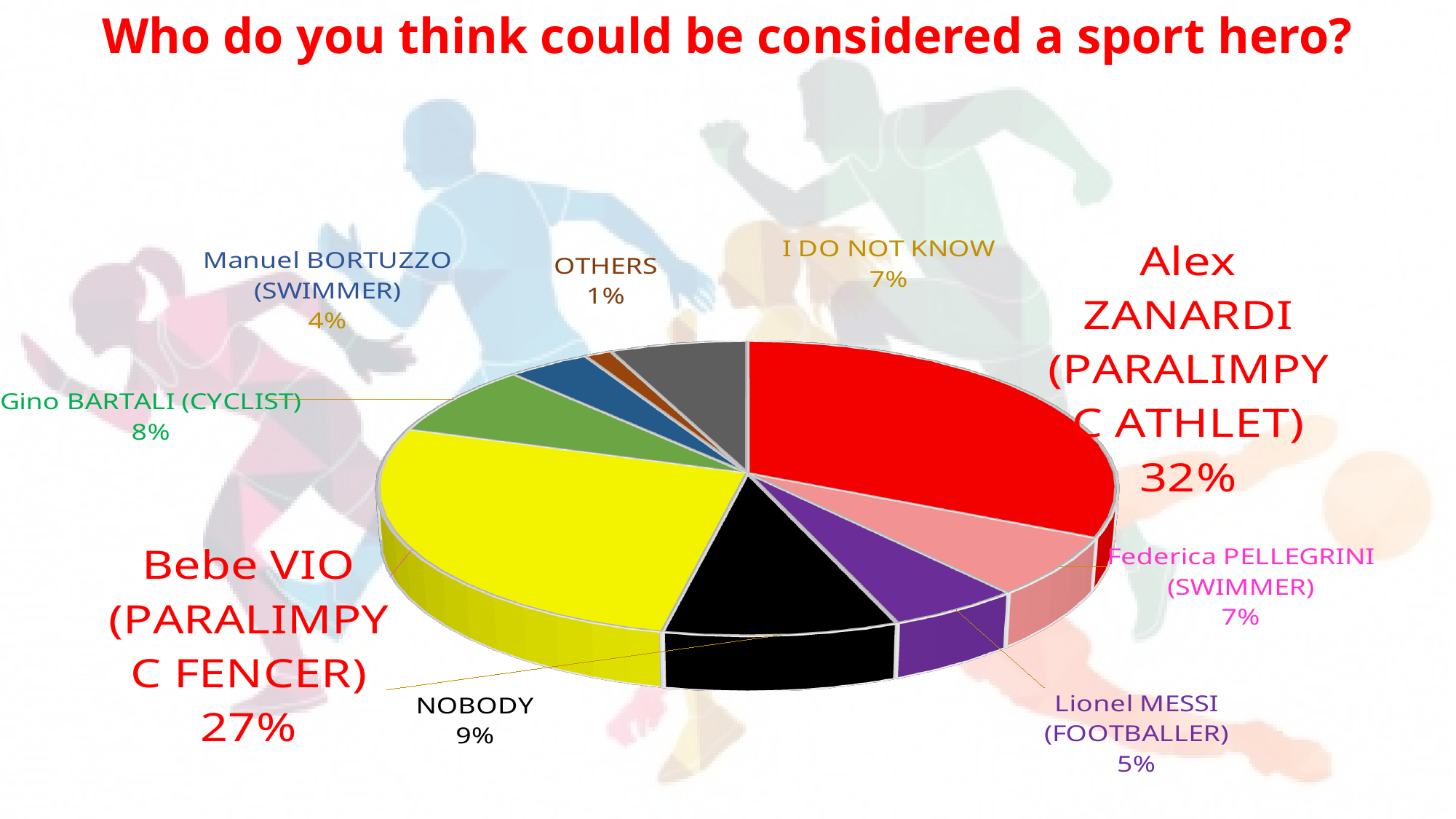
What percentage is shown for Gino BARTALI (CYCLIST)? 8% Which category has the smallest slice of the pie? OTHERS What share of the pie is Alex ZANARDI (PARALIMPYC ATHLET)? 32% What share of the pie is Bebe VIO (PARALIMPYC FENCER)? 27% What percentage of respondents answered NOBODY? 9% How many categories are shown in the pie chart? 9 Which is larger, the share for Manuel BORTUZZO (SWIMMER) or the share for Federica PELLEGRINI (SWIMMER)? Federica PELLEGRINI (SWIMMER) What kind of chart is shown on the slide? pie chart Which category has the largest slice of the pie? Alex ZANARDI (PARALIMPYC ATHLET) What percentage is shown for Lionel MESSI (FOOTBALLER)? 5% What is the title of the chart? Who do you think could be considered a sport hero? What is the difference in percentage points between Alex ZANARDI and Bebe VIO? 5